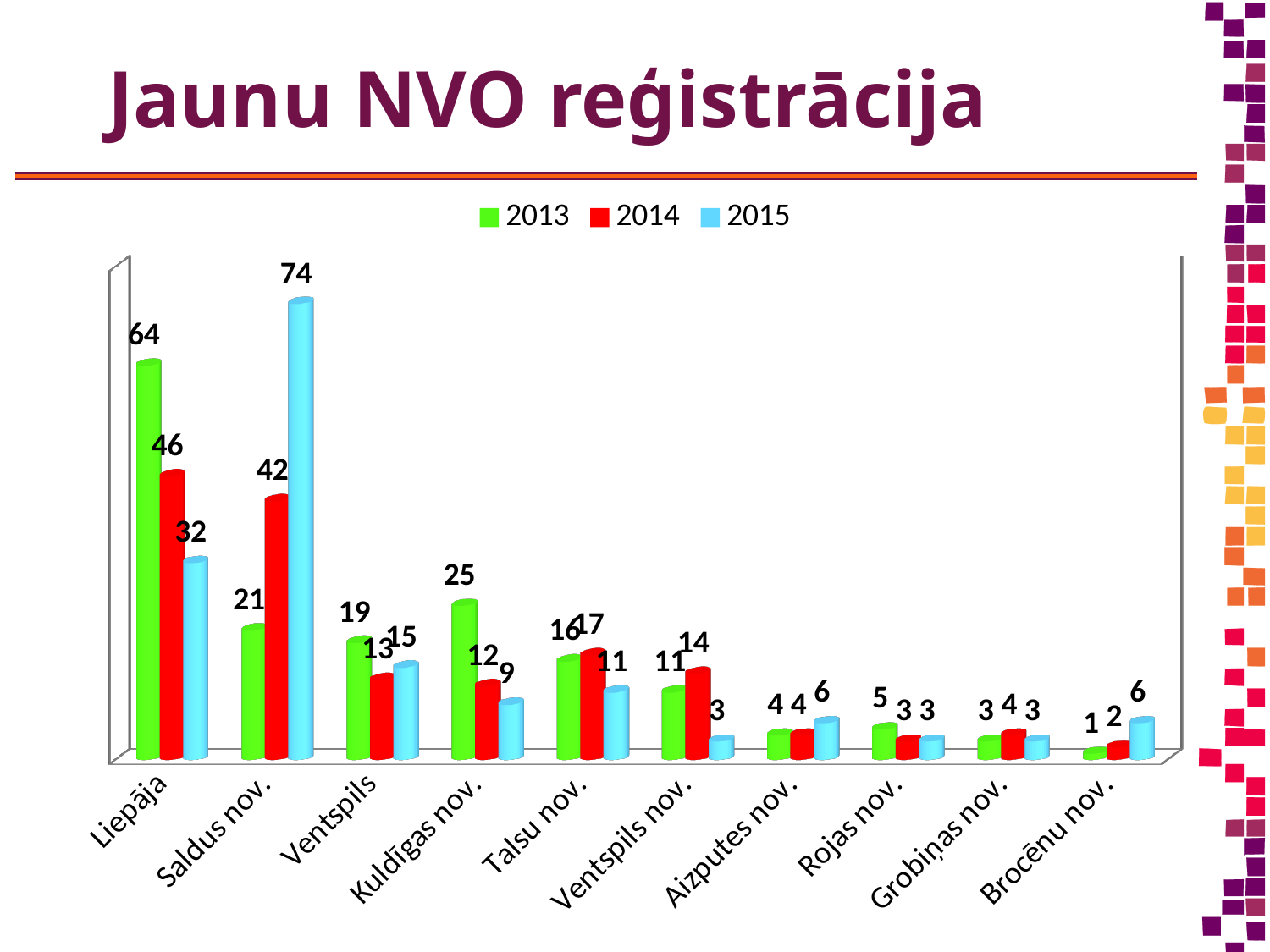
Which category has the highest value in the 2013 series? Liepāja What kind of chart is shown on the slide? Bar chart What is the title of the slide? Jaunu NVO reģistrācija Which category has the lowest value in the 2013 series? Brocēnu nov. What is the value for Saldus nov. in the 2015 series? 74 For Saldus nov., which series has the larger value, 2014 or 2015? 2015 How many categories are shown on the x axis? 10 What is the value for Liepāja in the 2013 series? 64 What is the value for Kuldīgas nov. in the 2013 series? 25 How many series does the legend list? 3 What is the difference between the 2013 and 2014 values for Liepāja? 18 Which category has the highest value in the 2015 series? Saldus nov.